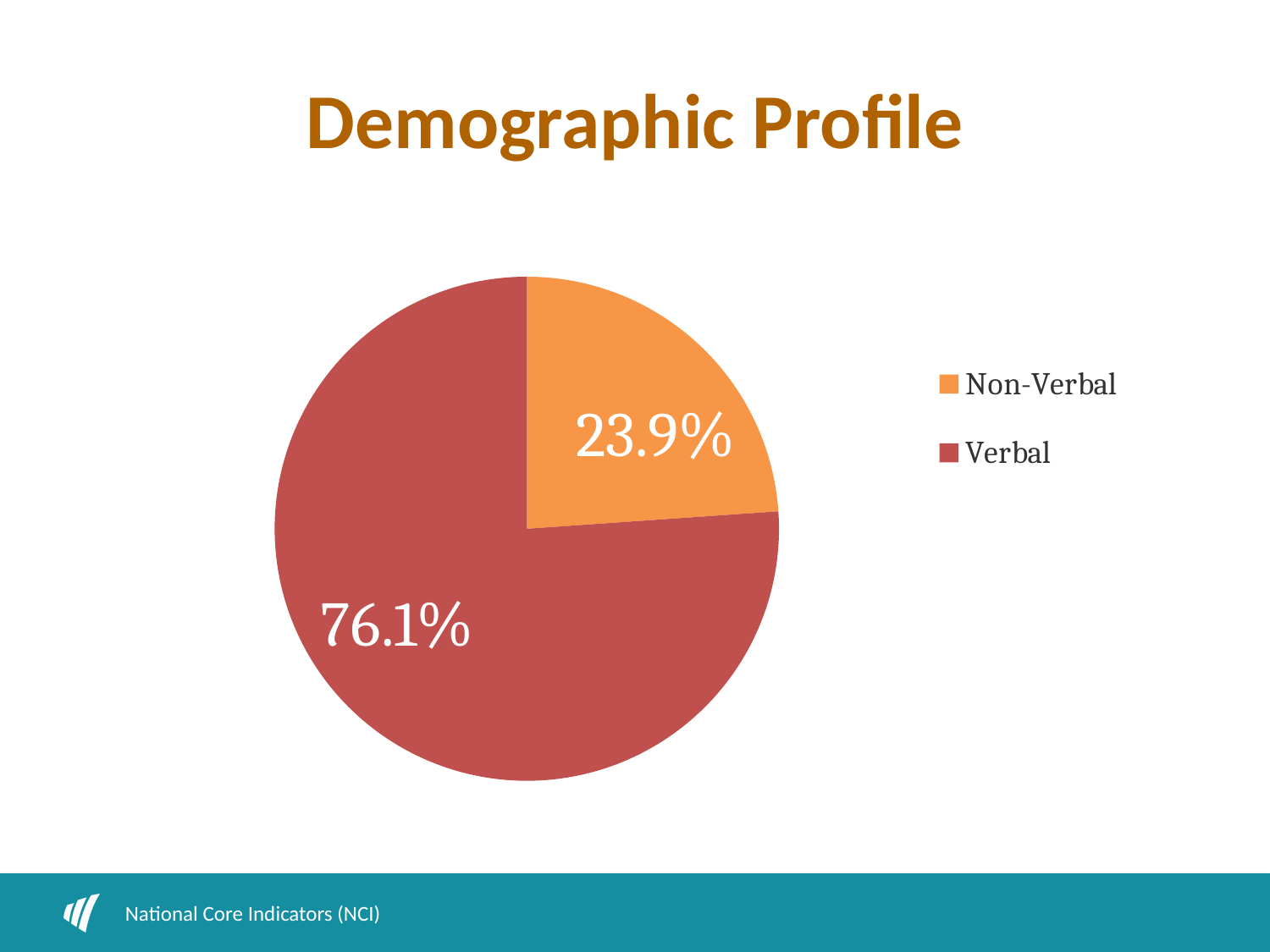
Which slice is the largest? Verbal How many slices does the pie chart have? 2 What share of the pie is Verbal? 76.1% What kind of chart is shown on the slide? pie chart Which slice is the smallest? Non-Verbal Which is larger, the Verbal slice or the Non-Verbal slice? Verbal What share of the pie is Non-Verbal? 23.9% What colour is the Non-Verbal slice? orange How many entries does the legend list? 2 What is the title of the slide containing the chart? Demographic Profile What is the difference between the Verbal and Non-Verbal shares? 52.2%